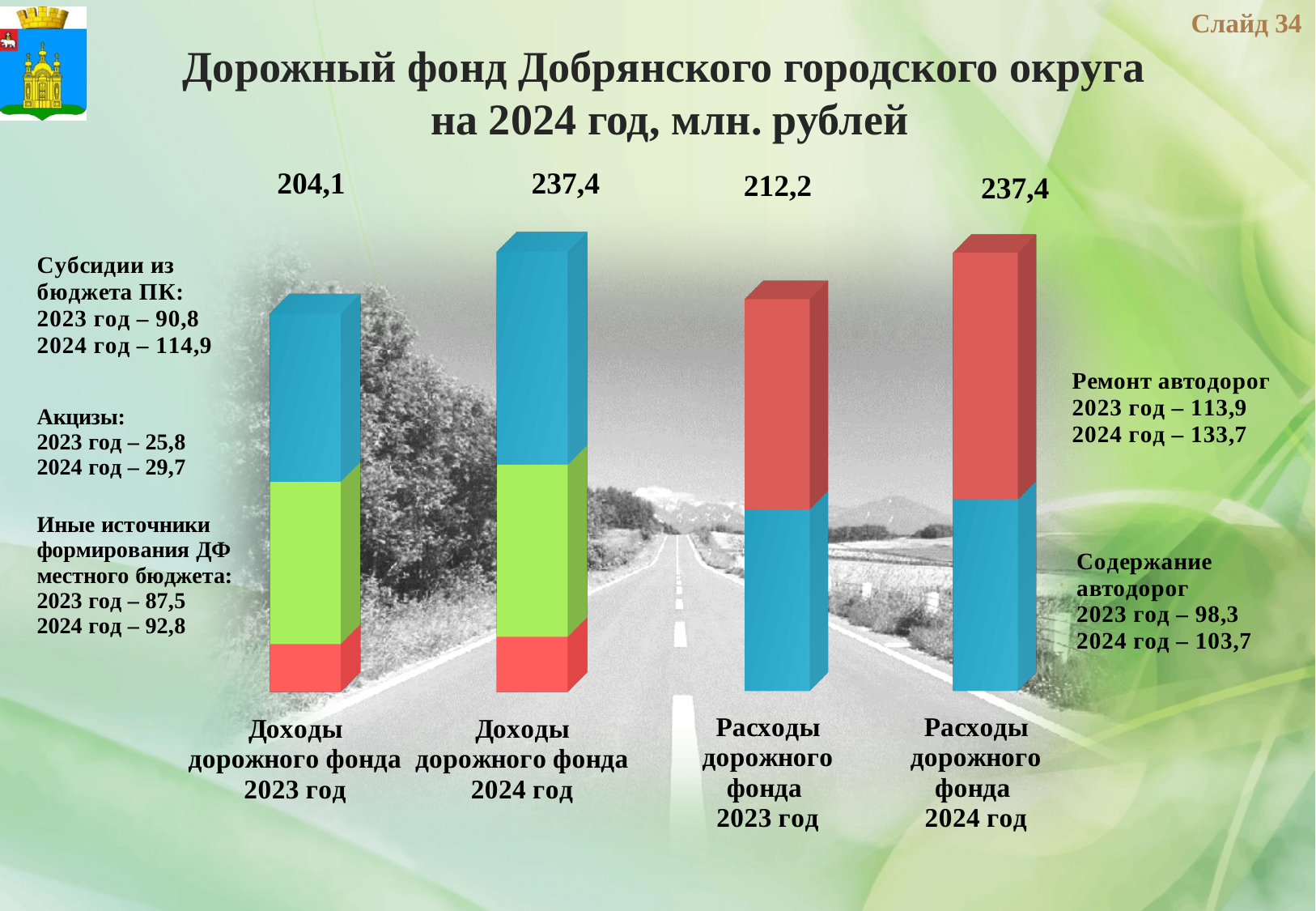
According to the slide, what is the value of Ремонт автодорог for 2023 год? 113,9 By how much does Содержание автодорог increase from 2023 год to 2024 год? 5,4 Which is larger: Доходы дорожного фонда 2023 год or Расходы дорожного фонда 2023 год? Расходы дорожного фонда 2023 год Which bar has the lowest total value? Доходы дорожного фонда 2023 год How many bars are shown in the chart? 4 According to the slide, what is the value of Субсидии из бюджета ПК for 2024 год? 114,9 What is the total value shown for Доходы дорожного фонда 2023 год? 204,1 Do the totals for Доходы дорожного фонда rise or fall from 2023 год to 2024 год? Rise What is the total value shown for Расходы дорожного фонда 2024 год? 237,4 What kind of chart is shown on the slide? Stacked bar chart What is the difference between the totals for Расходы дорожного фонда 2024 год and Расходы дорожного фонда 2023 год? 25,2 What is the difference between the totals for Доходы дорожного фонда 2024 год and Доходы дорожного фонда 2023 год? 33,3